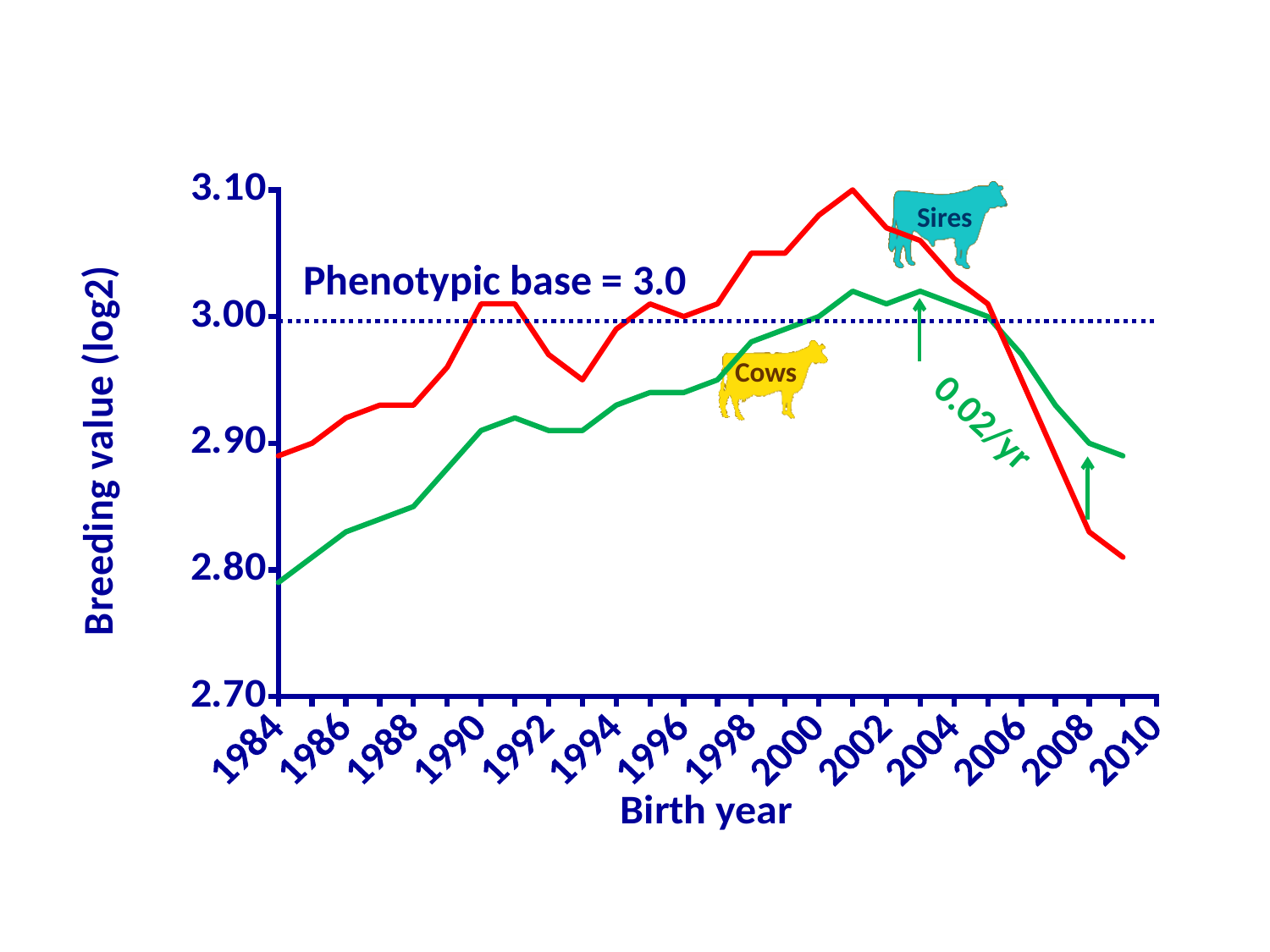
Is the breeding value for Sires in 2002 greater or less than 3.00? greater Is the breeding value for Sires in 1984 greater or less than 2.80? greater In 1990, which series has the higher breeding value, Sires or Cows? Sires In 2008, which series has the higher breeding value, Sires or Cows? Cows Does the breeding value for Sires rise or fall between 2002 and 2010? fall How many series are plotted on the chart? 2 Is the breeding value for Cows in 1984 greater or less than 2.90? less What kind of chart is shown on the slide? line chart What value is the phenotypic base shown by the dotted line? 3.0 Which series reaches the highest breeding value on the chart? Sires